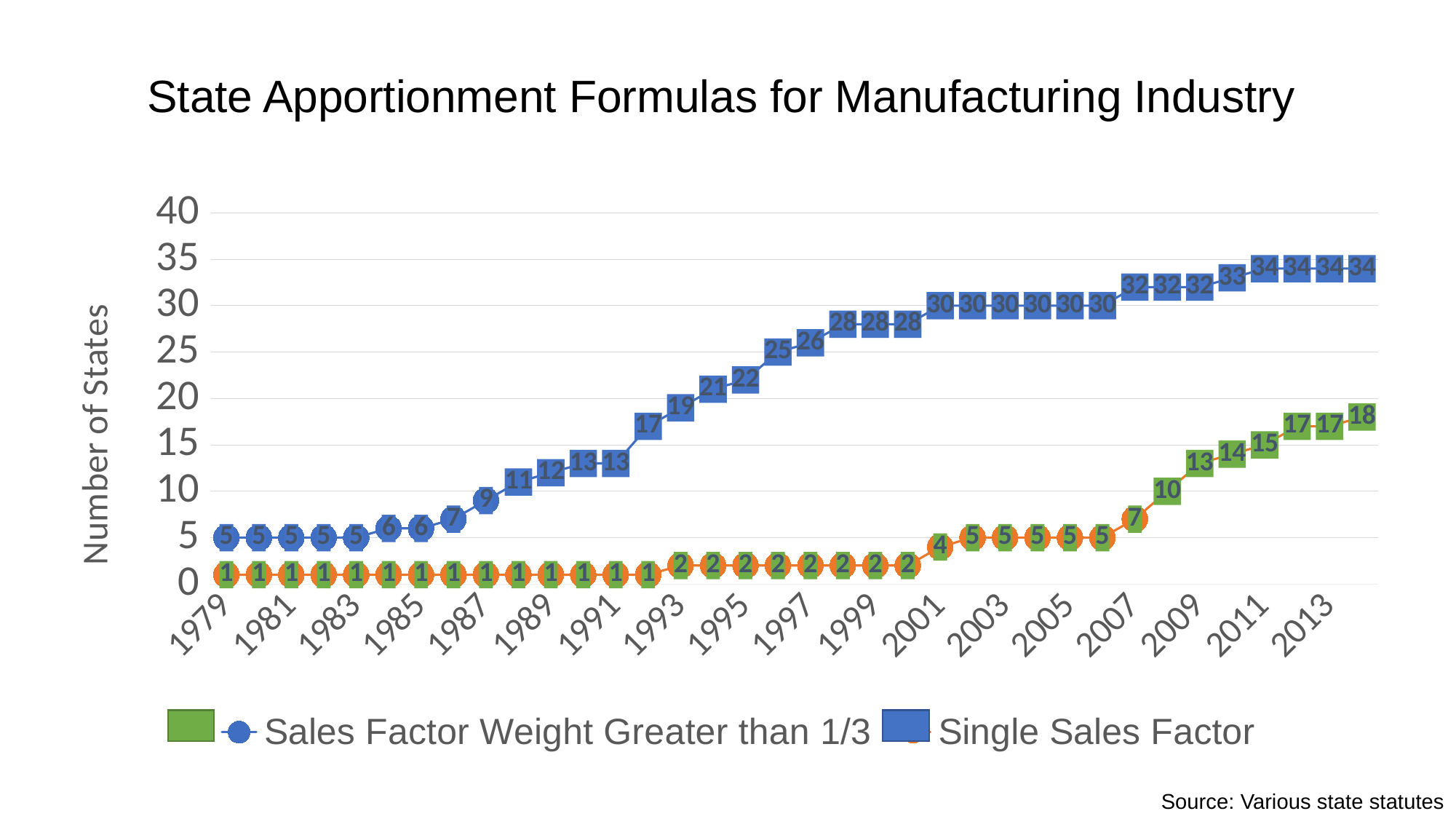
What is the value of the upper (blue) line in 1993? 19 What is the value of the lower (green/orange) line in 2009? 13 What type of chart is shown on the slide? Line chart What is the highest value reached by the upper (blue) line? 34 In 2007, which line has the larger value, the upper (blue) line or the lower (green/orange) line? The upper (blue) line Do the values of the upper (blue) line rise or fall from 1979 to 2013? Rise How many series does the legend list? 2 What is the value of the lower (green/orange) line in 2013? 17 What is the lowest value shown on the lower (green/orange) line? 1 What is the difference between the upper (blue) line and the lower (green/orange) line in 2013? 17 What is the value of the upper (blue) line in 2001? 30 What is the y-axis title of the chart? Number of States